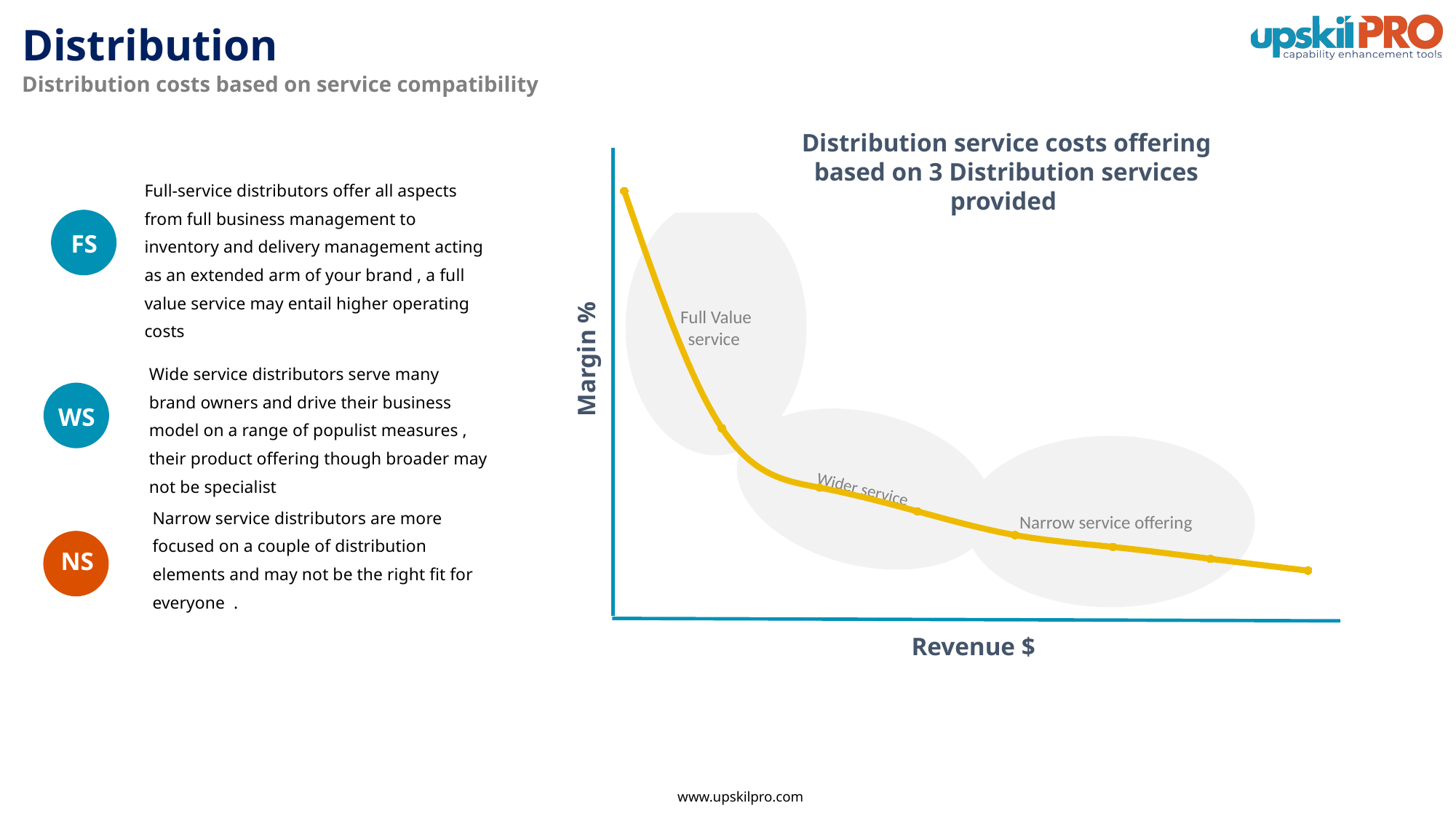
Which labelled service region sits at the lowest margin % on the curve? Narrow service offering What is the title of the chart? Distribution service costs offering based on 3 Distribution services provided Which labelled service region sits at the highest margin % on the curve? Full Value service Does the margin % rise or fall as revenue $ increases along the x axis? fall What kind of chart is shown on the slide? line chart How many service regions are labelled along the curve? 3 Which has the higher revenue $ position on the curve, Wider service or Narrow service offering? Narrow service offering Which labelled service region is positioned furthest to the right along the revenue $ axis? Narrow service offering Which has the higher margin % on the curve, Full Value service or Wider service? Full Value service What label is on the vertical axis of the chart? Margin %